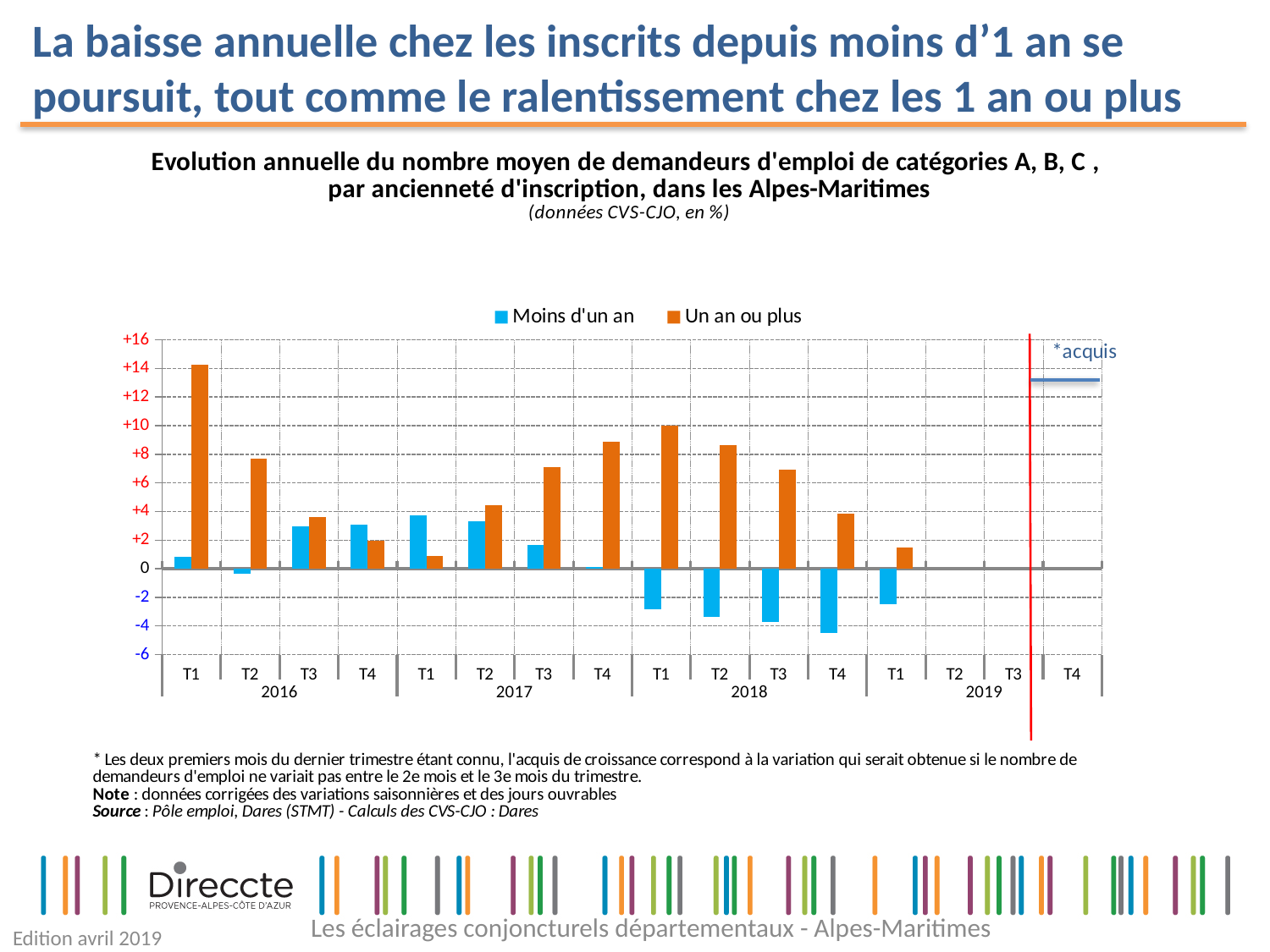
How many years are labelled on the x axis? 4 What are the two series named in the legend? Moins d'un an; Un an ou plus In which quarter is the value for 'Moins d'un an' the lowest? T4 2018 Is the value for 'Un an ou plus' in T1 2016 greater or less than +12? greater Is the value for 'Un an ou plus' in T1 2018 greater or less than +8? greater From T1 2018 to T1 2019, do the values for 'Un an ou plus' rise or fall? fall In which quarter is the value for 'Un an ou plus' the highest? T1 2016 In T3 2017, which series has the larger value, 'Moins d'un an' or 'Un an ou plus'? Un an ou plus How many series does the legend list? 2 In T1 2017, which series has the larger value, 'Moins d'un an' or 'Un an ou plus'? Moins d'un an What kind of chart is shown on the slide? bar chart Is the value for 'Moins d'un an' in T4 2018 greater or less than -2? less